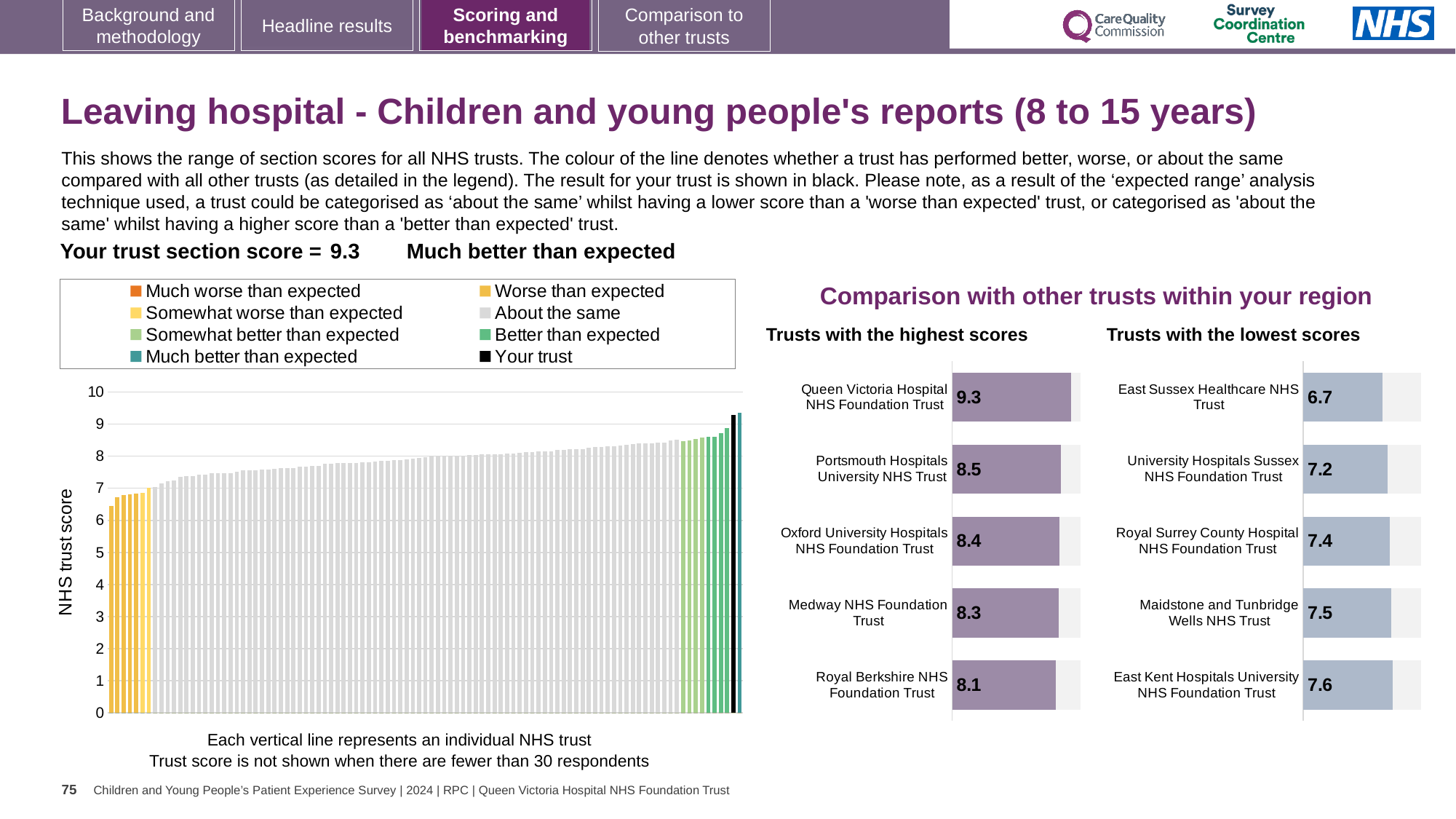
In the 'Trusts with the lowest scores' chart, which trust has the lowest score? East Sussex Healthcare NHS Trust In the 'Trusts with the highest scores' chart, what is the difference between the scores of Queen Victoria Hospital NHS Foundation Trust and Royal Berkshire NHS Foundation Trust? 1.2 In the 'Trusts with the lowest scores' chart, what is the score for Royal Surrey County Hospital NHS Foundation Trust? 7.4 How many trusts are shown in the 'Trusts with the lowest scores' chart? 5 In the left-hand chart showing the range of section scores for all NHS trusts, do the bar values rise or fall from left to right? rise In the 'Trusts with the highest scores' chart, which has the larger score: Oxford University Hospitals NHS Foundation Trust or Medway NHS Foundation Trust? Oxford University Hospitals NHS Foundation Trust What kind of chart is the 'Trusts with the highest scores' chart? Bar chart In the 'Trusts with the highest scores' chart, which trust has the highest score? Queen Victoria Hospital NHS Foundation Trust In the 'Trusts with the highest scores' chart, what is the score for Portsmouth Hospitals University NHS Trust? 8.5 In the 'Trusts with the lowest scores' chart, what is the difference between the scores of East Kent Hospitals University NHS Foundation Trust and East Sussex Healthcare NHS Trust? 0.9 How many entries does the legend of the left-hand chart showing the range of section scores list? 8 In the left-hand chart showing the range of section scores for all NHS trusts, is the value of the black 'Your trust' bar greater or less than 9? greater